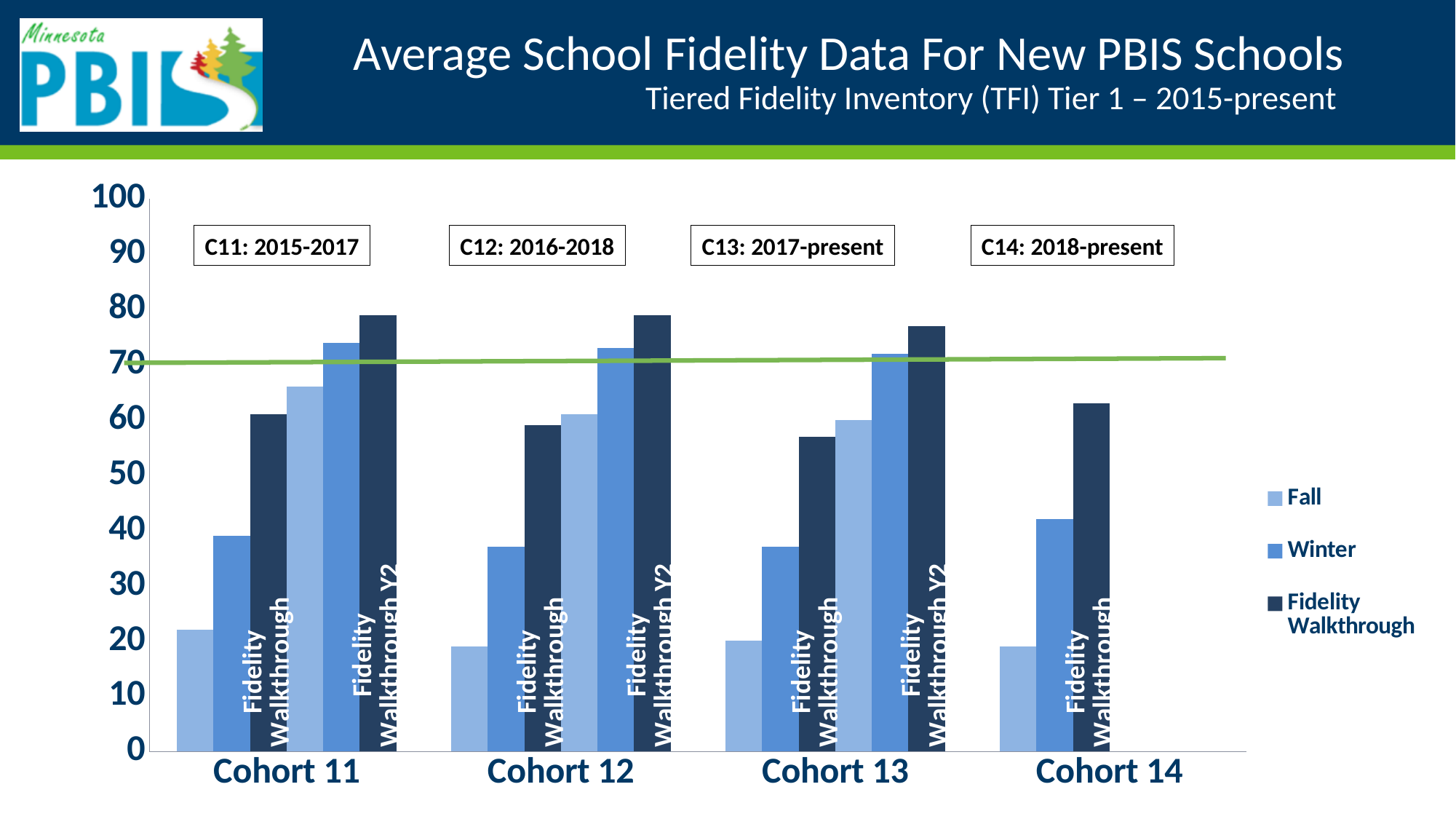
What years does the label box for C13 give? 2017-present Within Cohort 11, do the bars rise or fall from the first Fall bar to the Fidelity Walkthrough Y2 bar? rise How many bars are plotted for Cohort 14? 3 How many series does the legend list? 3 Is the Fidelity Walkthrough Y2 value for Cohort 11 greater or less than 70? greater Is the first Fall value for Cohort 11 greater or less than 30? less How many cohorts are shown along the x axis? 4 Is the Fidelity Walkthrough value for Cohort 14 greater or less than 70? less What are the three legend entries of the chart? Fall, Winter, Fidelity Walkthrough What kind of chart is shown on the slide? bar chart Which is larger: the Fidelity Walkthrough Y2 value for Cohort 11 or the Fidelity Walkthrough value for Cohort 14? Cohort 11 Fidelity Walkthrough Y2